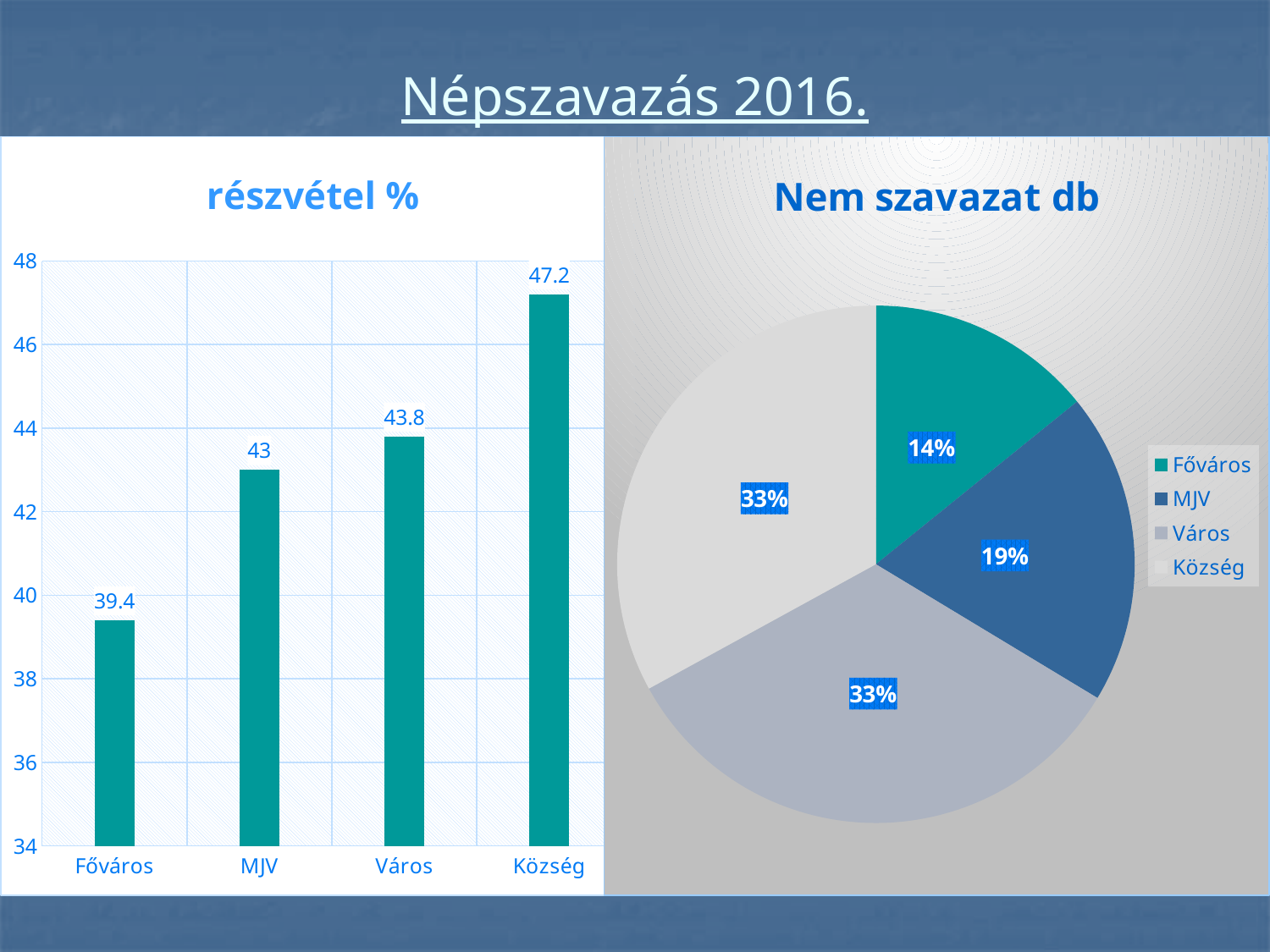
In the 'részvétel %' chart, what is the value for Község? 47.2 In the 'részvétel %' chart, which category has the lowest value? Főváros In the 'részvétel %' chart, which category has the highest value? Község In the 'részvétel %' chart, which is larger, the value for MJV or the value for Város? Város What kind of chart is the 'részvétel %' chart? bar chart In the 'részvétel %' chart, what is the value for Főváros? 39.4 In the 'részvétel %' chart, do the values rise or fall from Főváros to Község along the x axis? rise In the 'Nem szavazat db' chart, what share does MJV have? 19% In the 'Nem szavazat db' chart, what share does Főváros have? 14% How many entries does the legend of the 'Nem szavazat db' chart list? 4 In the 'részvétel %' chart, how many categories are shown? 4 In the 'részvétel %' chart, what is the difference between the values for Község and Főváros? 7.8